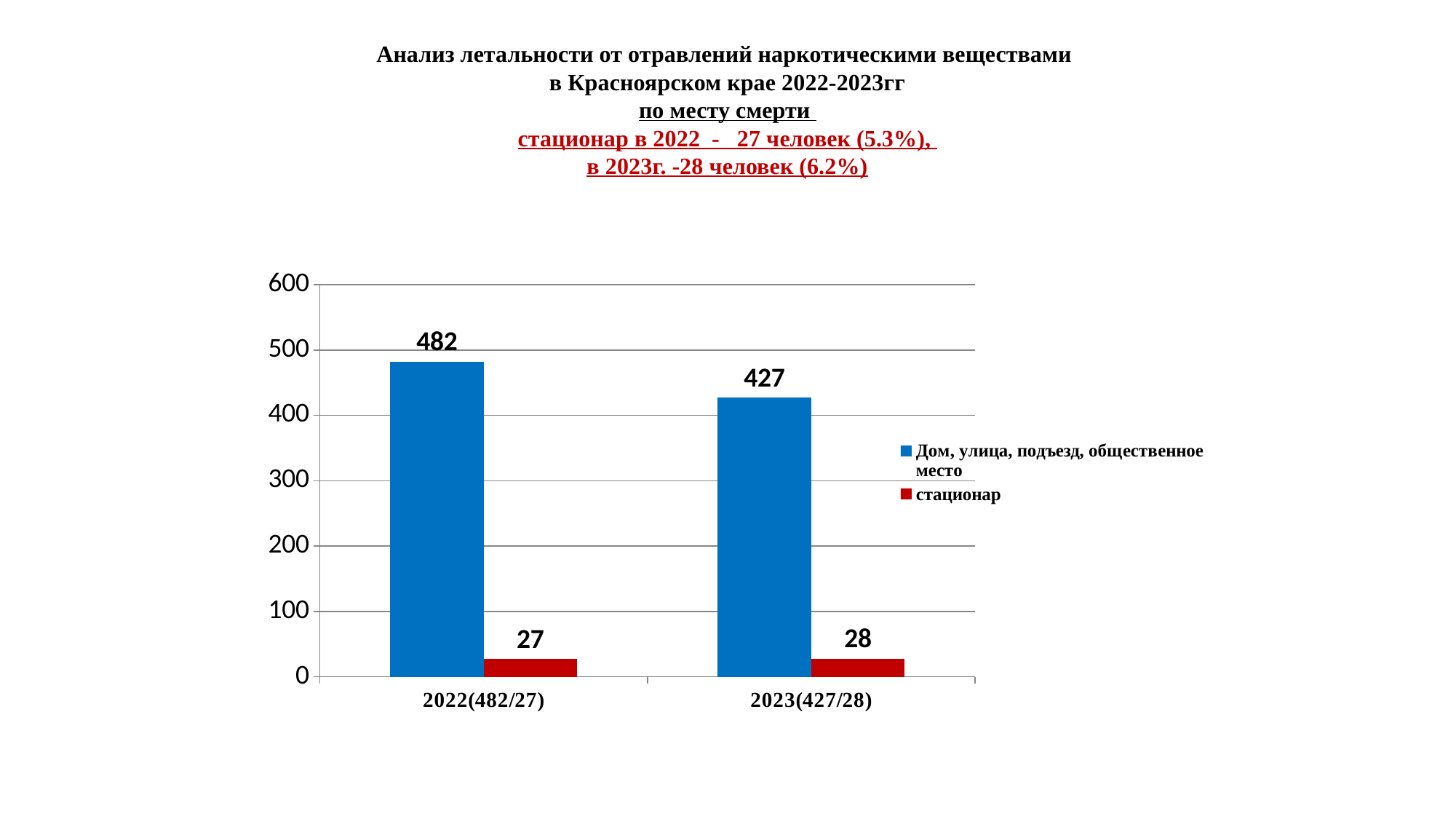
How many series does the legend list? 2 What is the difference between the "стационар" values for 2023(427/28) and 2022(482/27)? 1 What is the value for "стационар" in 2023(427/28)? 28 In which category is the value for "Дом, улица, подъезд, общественное место" highest? 2022(482/27) What is the value for "Дом, улица, подъезд, общественное место" in 2023(427/28)? 427 What kind of chart is shown on the slide? bar chart What is the value for "Дом, улица, подъезд, общественное место" in 2022(482/27)? 482 Which is larger in 2022(482/27): "Дом, улица, подъезд, общественное место" or "стационар"? Дом, улица, подъезд, общественное место What is the difference between the "Дом, улица, подъезд, общественное место" values for 2022(482/27) and 2023(427/28)? 55 What is the value for "стационар" in 2022(482/27)? 27 How many categories are shown on the x axis? 2 Is the value for "Дом, улица, подъезд, общественное место" in 2023(427/28) greater or less than 400? greater